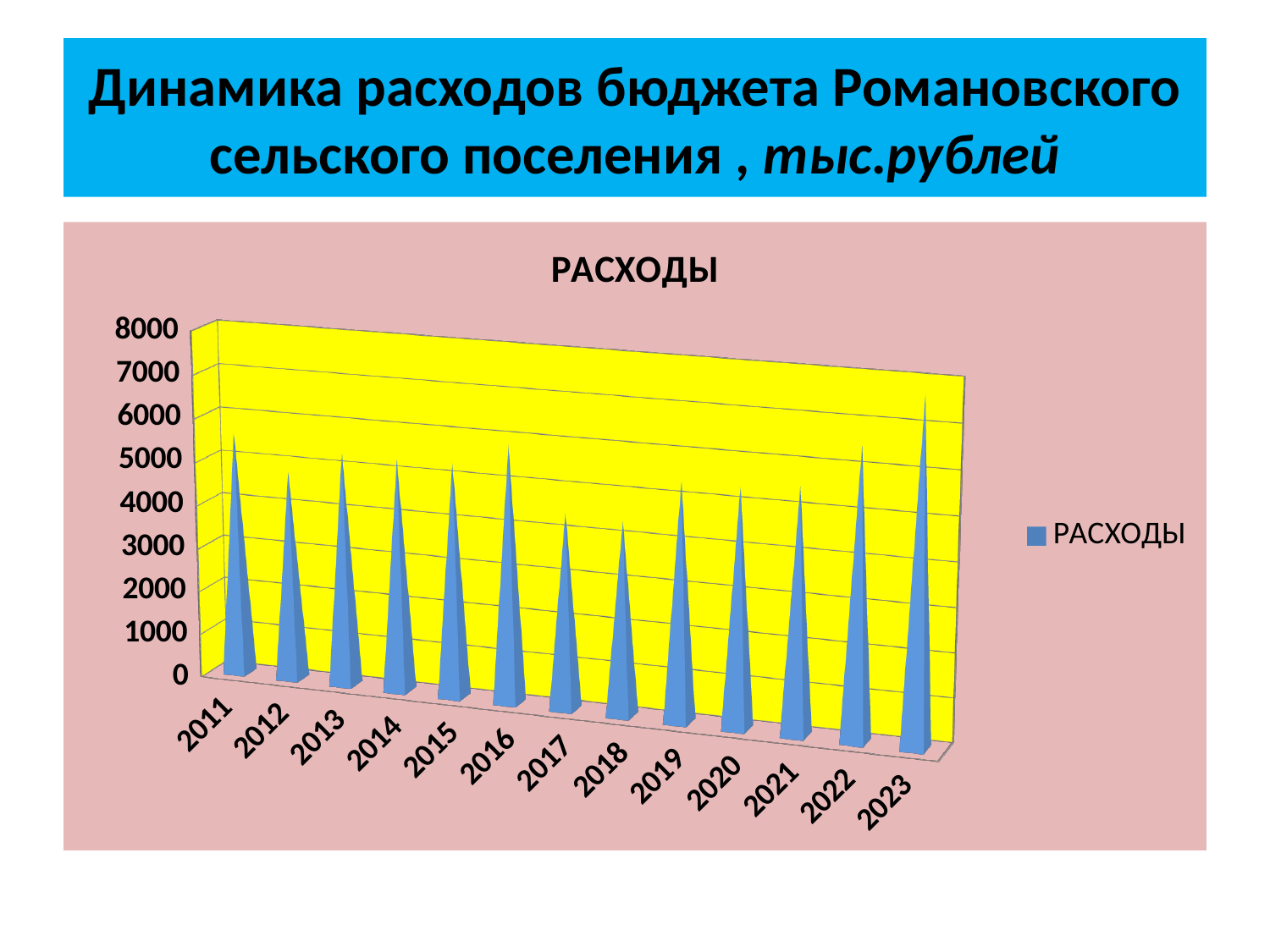
What unit of measurement is stated in the slide title? тыс.рублей Is the value for 2018 greater or less than 5000? less How many series does the legend list? 1 Is the value for 2023 greater or less than 4000? greater What is the title of the chart? РАСХОДЫ Which year has the highest value in the chart? 2023 Is the value for 2011 greater or less than 3000? greater Which is larger, the value for 2023 or the value for 2018? 2023 What kind of chart is shown on the slide? bar chart Which is larger, the value for 2011 or the value for 2017? 2011 Which year has the lowest value in the chart? 2018 How many years are shown on the x axis of the chart? 13